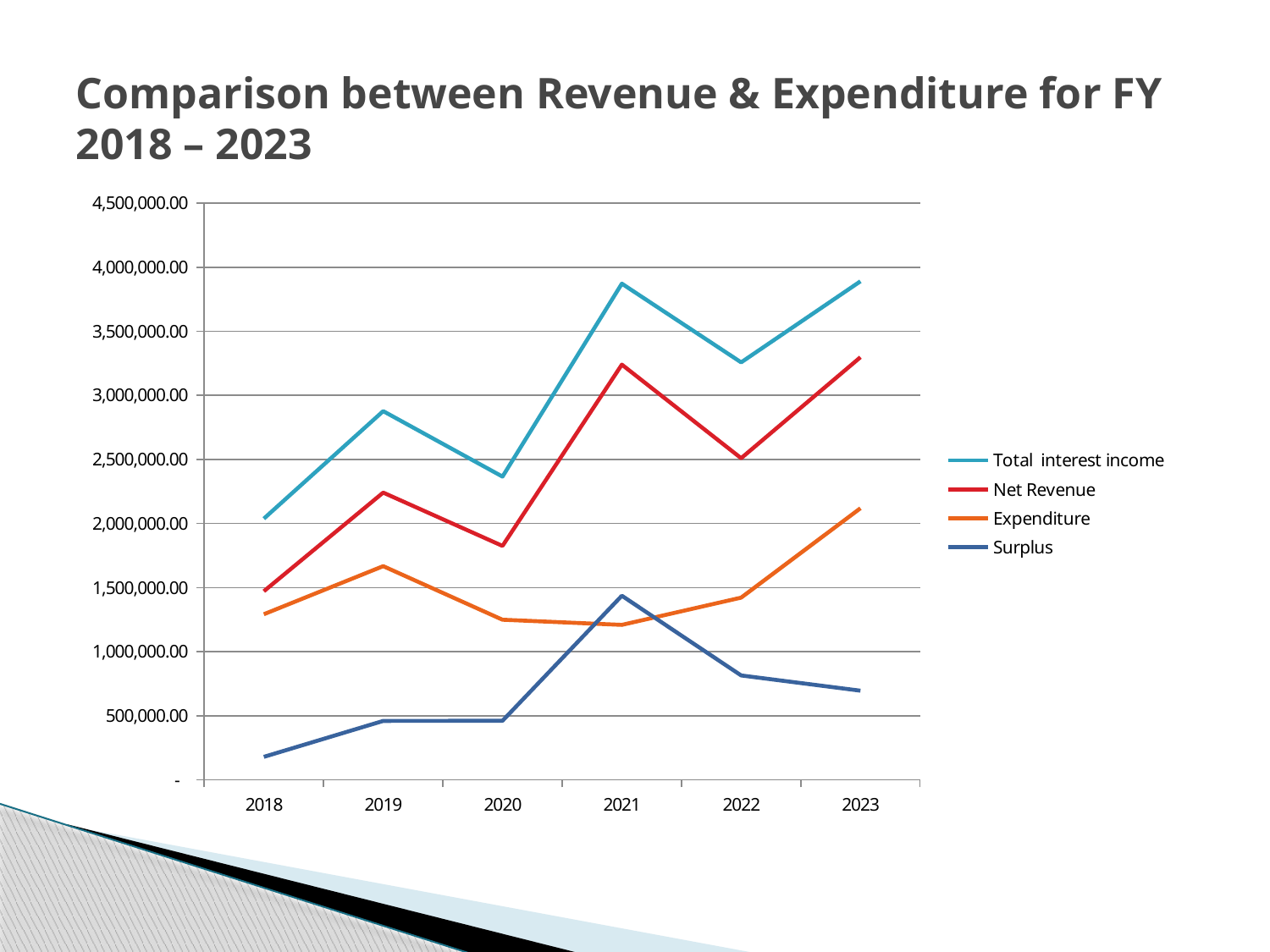
In which year is Total interest income lowest? 2018 How many series does the legend list? 4 Is the value for Total interest income in 2022 greater or less than 3,500,000.00? less Which is larger in 2019: Net Revenue or Expenditure? Net Revenue Does Surplus rise or fall from 2021 to 2023? fall Is the value for Surplus in 2021 greater or less than 1,000,000.00? greater In which year is Surplus highest? 2021 In which year is Surplus lowest? 2018 How many years are shown on the x axis? 6 What kind of chart is shown on the slide? line chart Is the value for Net Revenue in 2020 greater or less than 2,000,000.00? less In which year is Expenditure highest? 2023